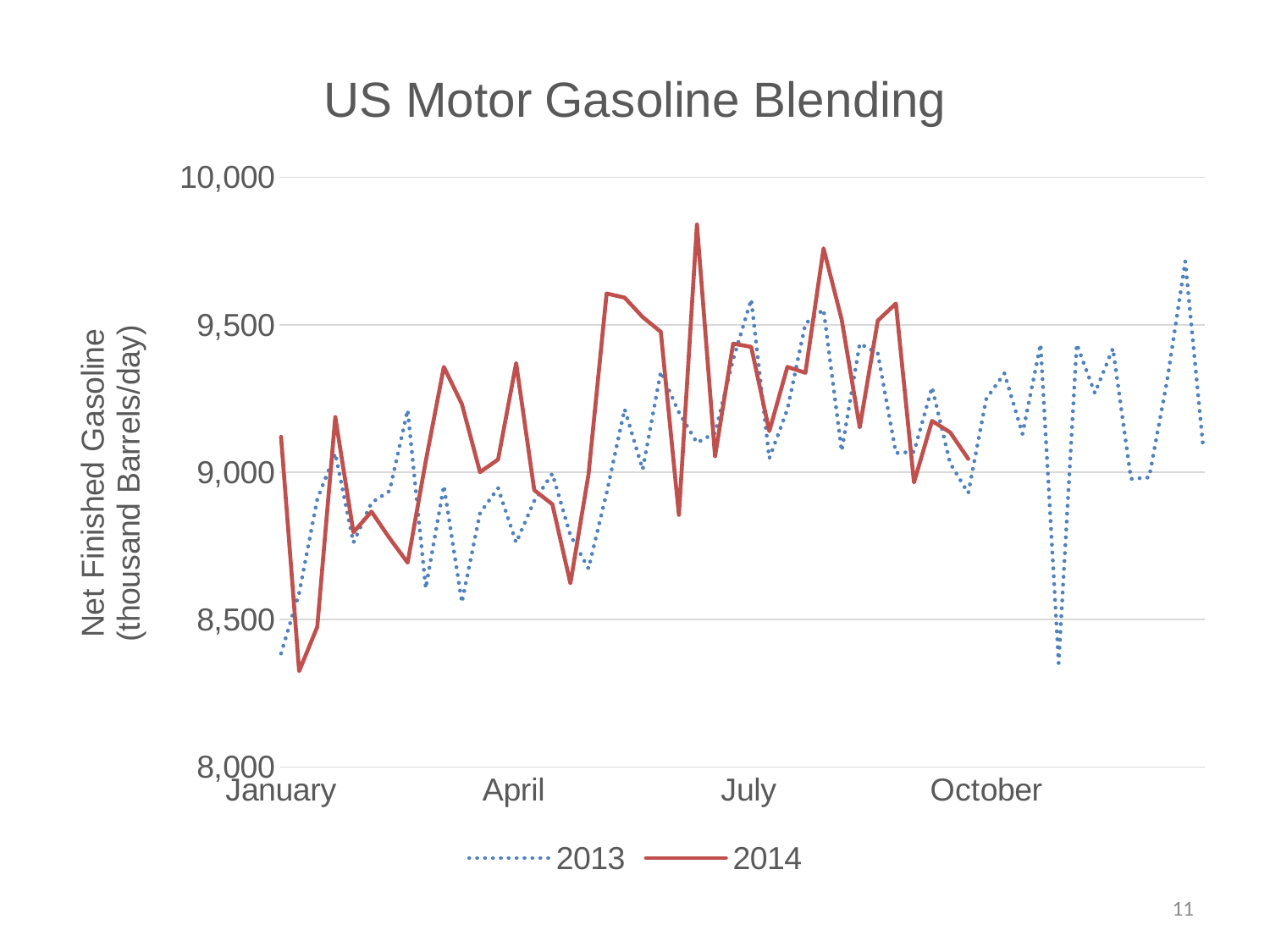
What kind of chart is shown on the slide? Line chart Which series reaches the higher peak value, 2013 or 2014? 2014 What is the label on the vertical axis? Net Finished Gasoline (thousand Barrels/day) How many month labels are shown on the horizontal axis? 4 Do the 2014 values generally rise or fall from January to July? rise What is the title of the chart? US Motor Gasoline Blending Is the highest 2014 value, reached around late July, greater or less than 9,500? greater Is the 2013 value at the end of the series (late December) greater or less than 9,000? greater Is the lowest 2013 value, reached around November, greater or less than 8,500? less How many series does the legend list? 2